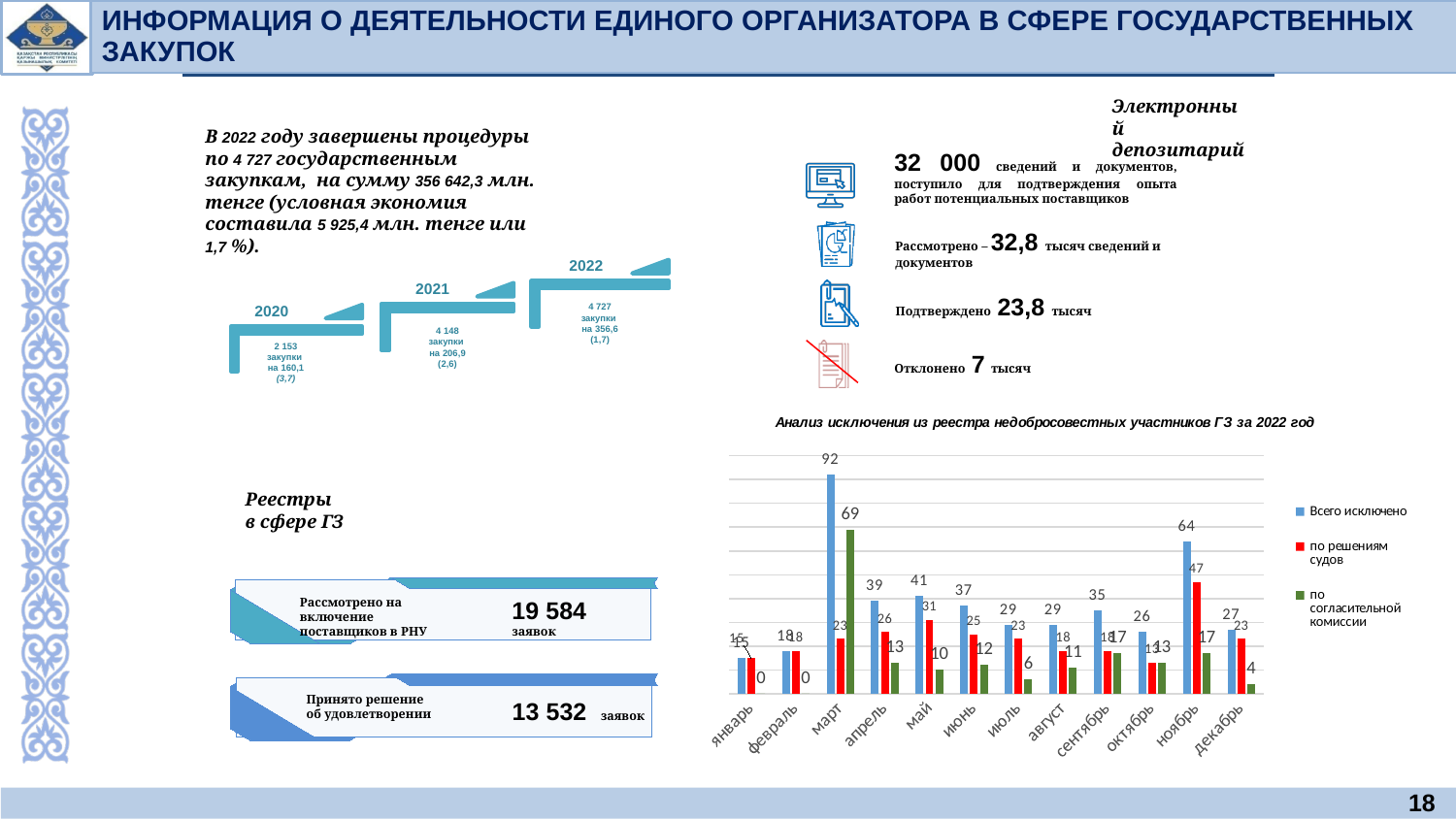
How many months (categories) are shown on the x axis of the bar chart? 12 In the bar chart, which is larger for май: 'по решениям судов' or 'по согласительной комиссии'? по решениям судов In the bar chart, which month has the lowest value for 'по согласительной комиссии' among months with a non-zero value? декабрь How many series does the legend of the bar chart list? 3 In the bar chart, what is the value of 'по решениям судов' for ноябрь? 47 In the bar chart, what is the value of 'Всего исключено' for сентябрь? 35 In the bar chart, which month has the highest value for 'Всего исключено'? март In the bar chart, what is the difference between 'Всего исключено' for март and for ноябрь? 28 In the bar chart, what is the value of 'Всего исключено' for март? 92 What kind of chart is shown under the title 'Анализ исключения из реестра недобросовестных участников ГЗ за 2022 год'? bar chart In the bar chart, what is the value of 'по согласительной комиссии' for март? 69 In the bar chart, what colour are the bars for 'по решениям судов'? red